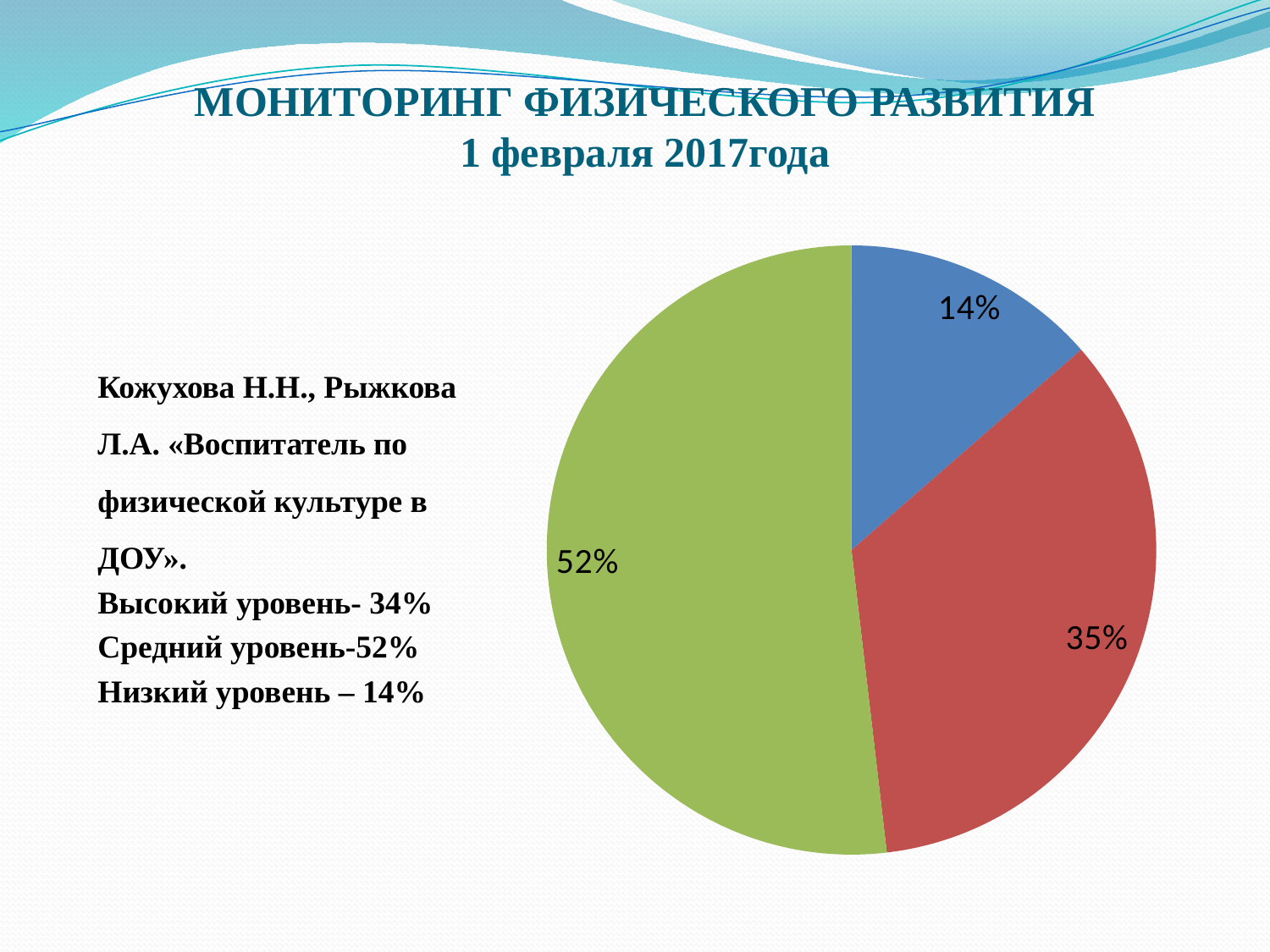
What kind of chart is shown on the slide? pie chart What is the value shown on the largest slice of the pie chart? 52% Which slice is larger, the red one or the blue one? the red one By how many percentage points does the green slice exceed the red slice? 17 What colour is the largest slice of the pie chart? green How many slices does the pie chart have? 3 What is the value shown on the smallest slice of the pie chart? 14% What value is labelled on the blue slice of the pie chart? 14% By how many percentage points does the green slice exceed the blue slice? 38 Does the pie chart display a legend? No What value is labelled on the green slice of the pie chart? 52% What value is labelled on the red slice of the pie chart? 35%